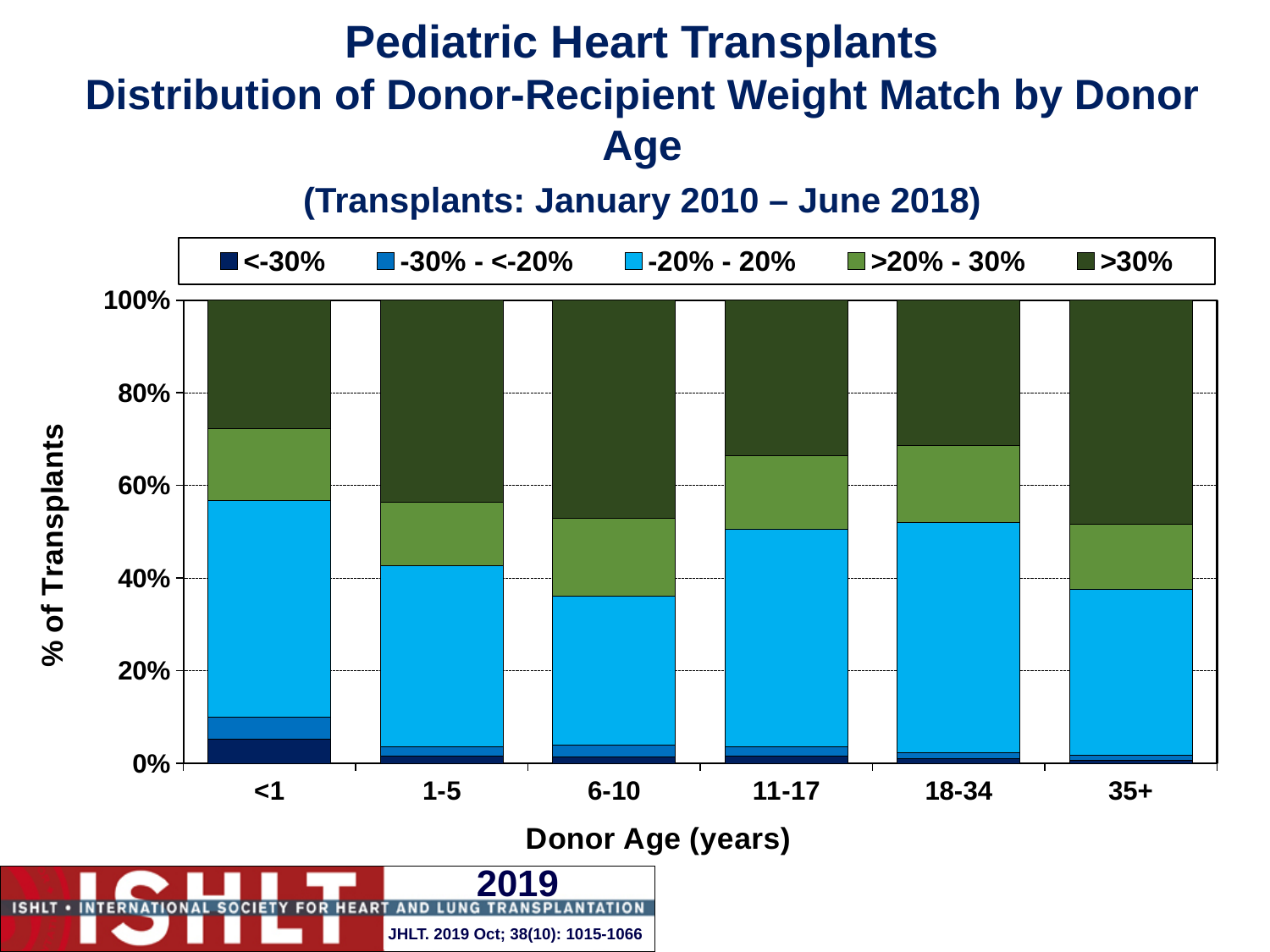
For the 6-10 donor age group, is the top of the ">20% - 30%" segment greater or less than 60%? less What is the label of the y axis? % of Transplants Which donor age group has the largest "-30% - <-20%" segment? <1 Which donor age group has the largest "<-30%" segment? <1 For the <1 donor age group, is the top of the ">20% - 30%" segment greater or less than 80%? less For the <1 donor age group, is the top of the "-20% - 20%" segment greater or less than 40%? greater What kind of chart is shown on the slide? Stacked bar chart How many series does the legend list? 5 How many donor age categories are shown on the x axis? 6 What is the label of the x axis? Donor Age (years)